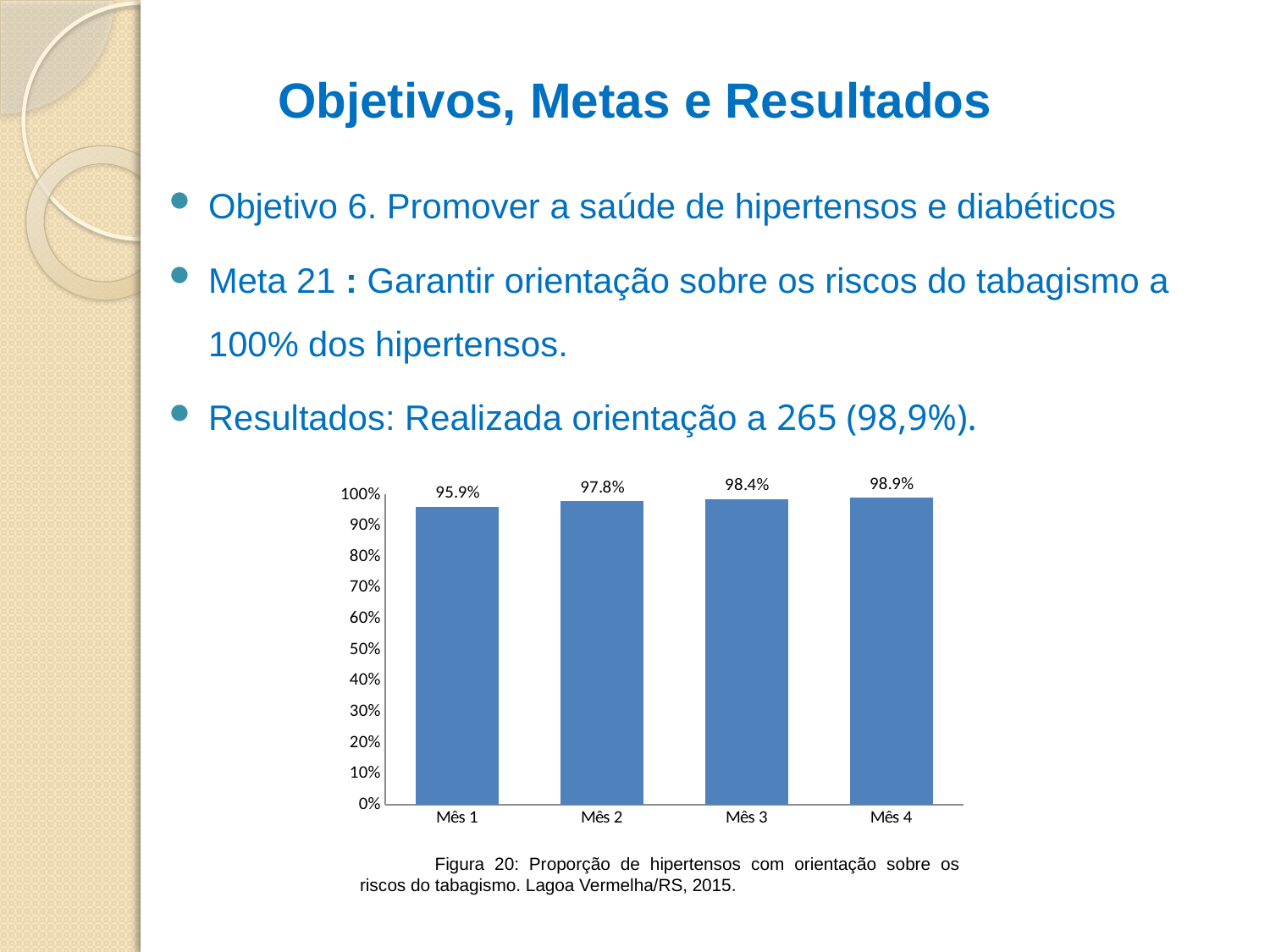
What is the value for Mês 4? 98.9% Which month has the highest value? Mês 4 What is the value for Mês 3? 98.4% What is the value for Mês 1? 95.9% Is the value for Mês 1 greater or less than 90%? greater What figure number is given in the caption below the chart? Figura 20 Which is larger, the value for Mês 2 or the value for Mês 3? Mês 3 What is the difference between the values for Mês 4 and Mês 1? 3.0% What kind of chart is shown on the slide? bar chart How many months are shown on the x axis? 4 Which month has the lowest value? Mês 1 Do the values rise or fall from Mês 1 to Mês 4? rise